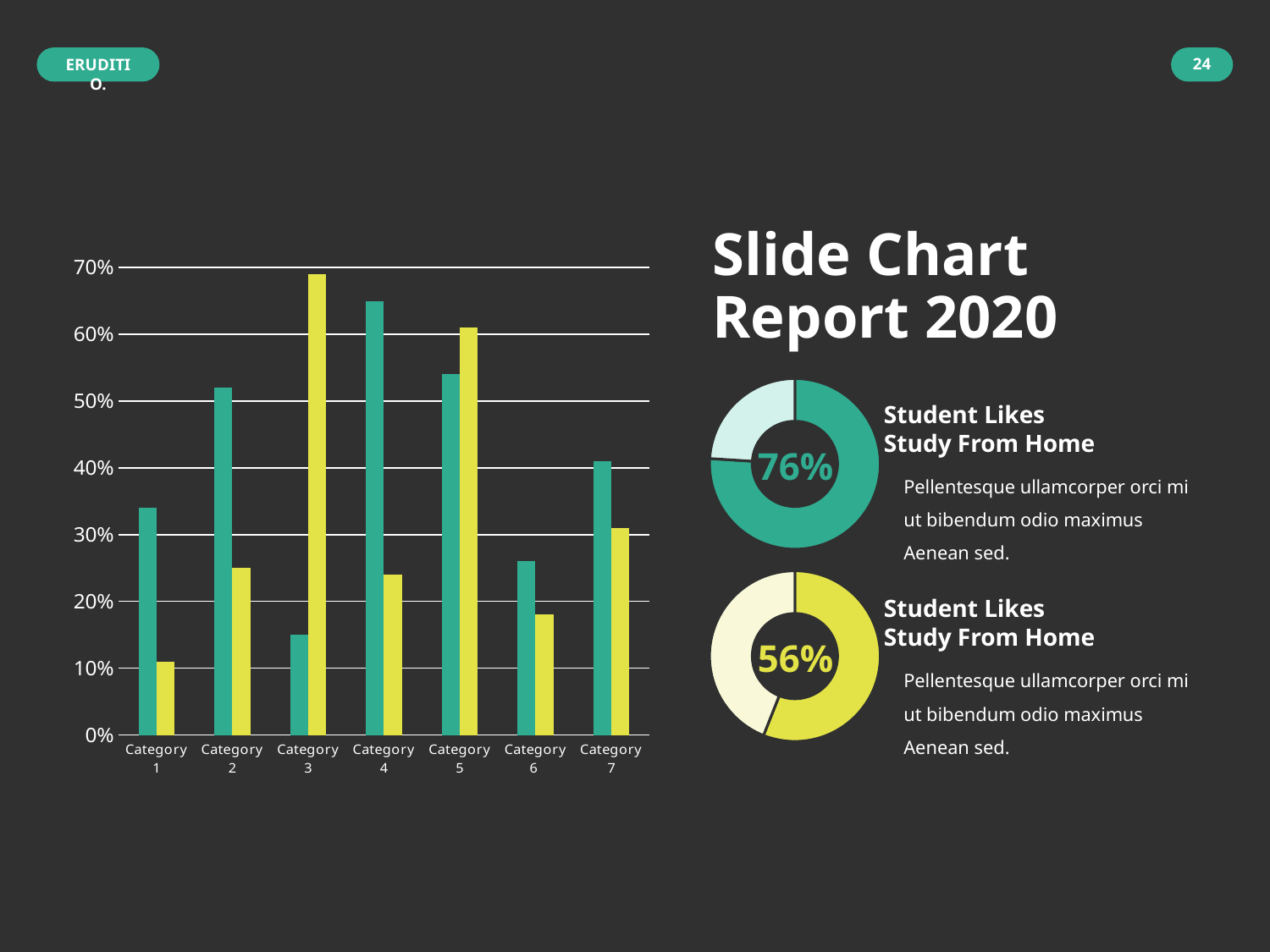
In the bar chart, is the yellow bar for Category 1 greater or less than 20%? less In the bar chart, for Category 2, which bar is taller, the green one or the yellow one? green What percentage is shown in the centre of the lower donut chart on the right of the slide? 56% How many categories are shown on the x axis of the bar chart? 7 In the bar chart, which category has the tallest yellow bar? Category 3 In the bar chart, for Category 5, which bar is taller, the green one or the yellow one? yellow How many bars are shown for each category in the bar chart? 2 In the bar chart, is the green bar for Category 4 greater or less than 60%? greater What kind of chart is the large chart on the left of the slide? bar chart In the bar chart, which category has the shortest green bar? Category 3 In the bar chart, is the yellow bar for Category 3 greater or less than 60%? greater What percentage is shown in the centre of the upper donut chart on the right of the slide? 76%